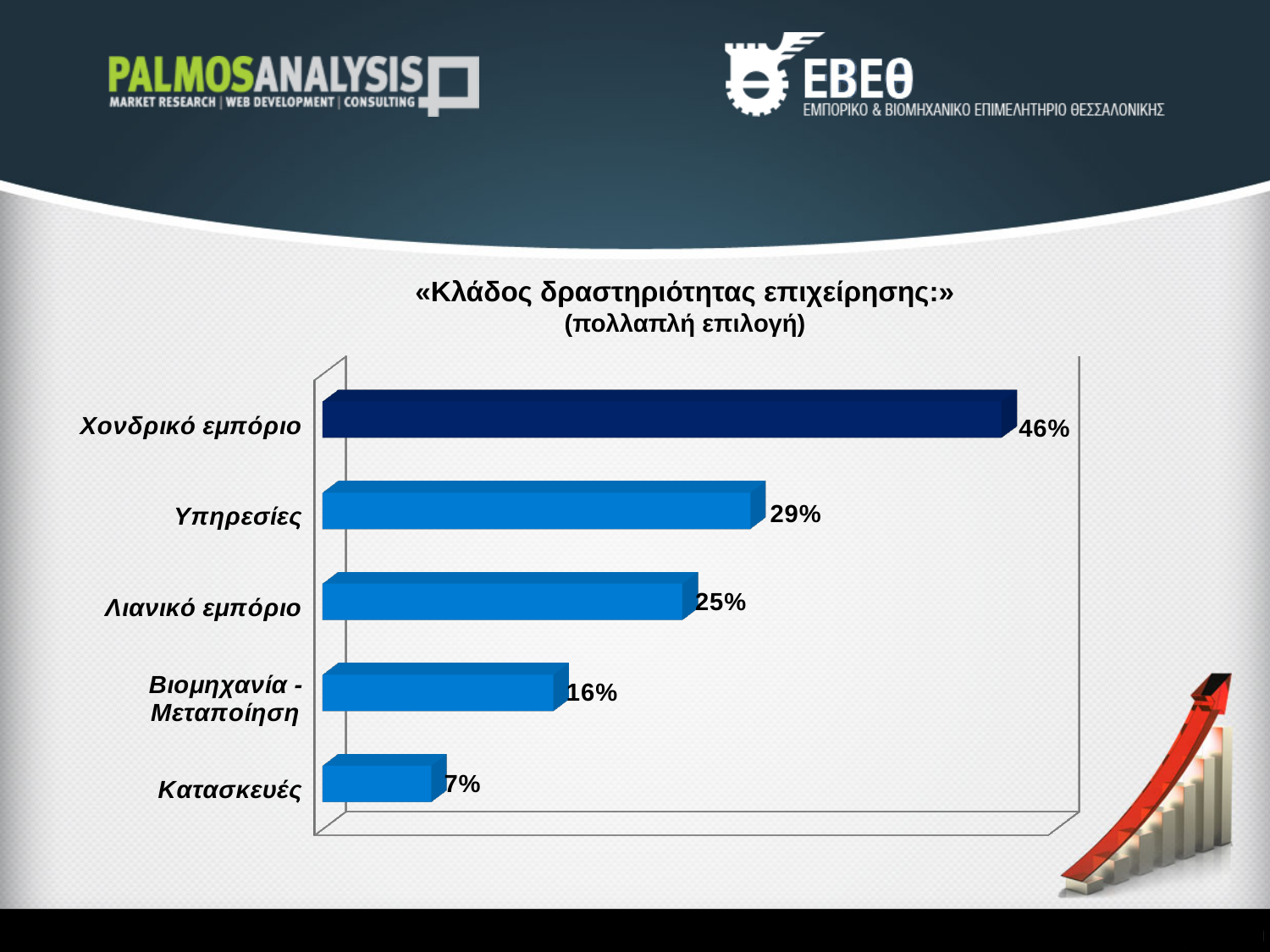
Which category has the lowest value? Κατασκευές What is the value for Βιομηχανία - Μεταποίηση? 16% What is the value for Υπηρεσίες? 29% What is the title of the chart? «Κλάδος δραστηριότητας επιχείρησης:» (πολλαπλή επιλογή) Which is larger, the value for Λιανικό εμπόριο or the value for Βιομηχανία - Μεταποίηση? Λιανικό εμπόριο What is the value for Κατασκευές? 7% Which category has the highest value? Χονδρικό εμπόριο What is the value for Χονδρικό εμπόριο? 46% What is the difference between the values for Χονδρικό εμπόριο and Υπηρεσίες? 17% What kind of chart is shown on the slide? Bar chart How many categories are shown in the chart? 5 What is the value for Λιανικό εμπόριο? 25%